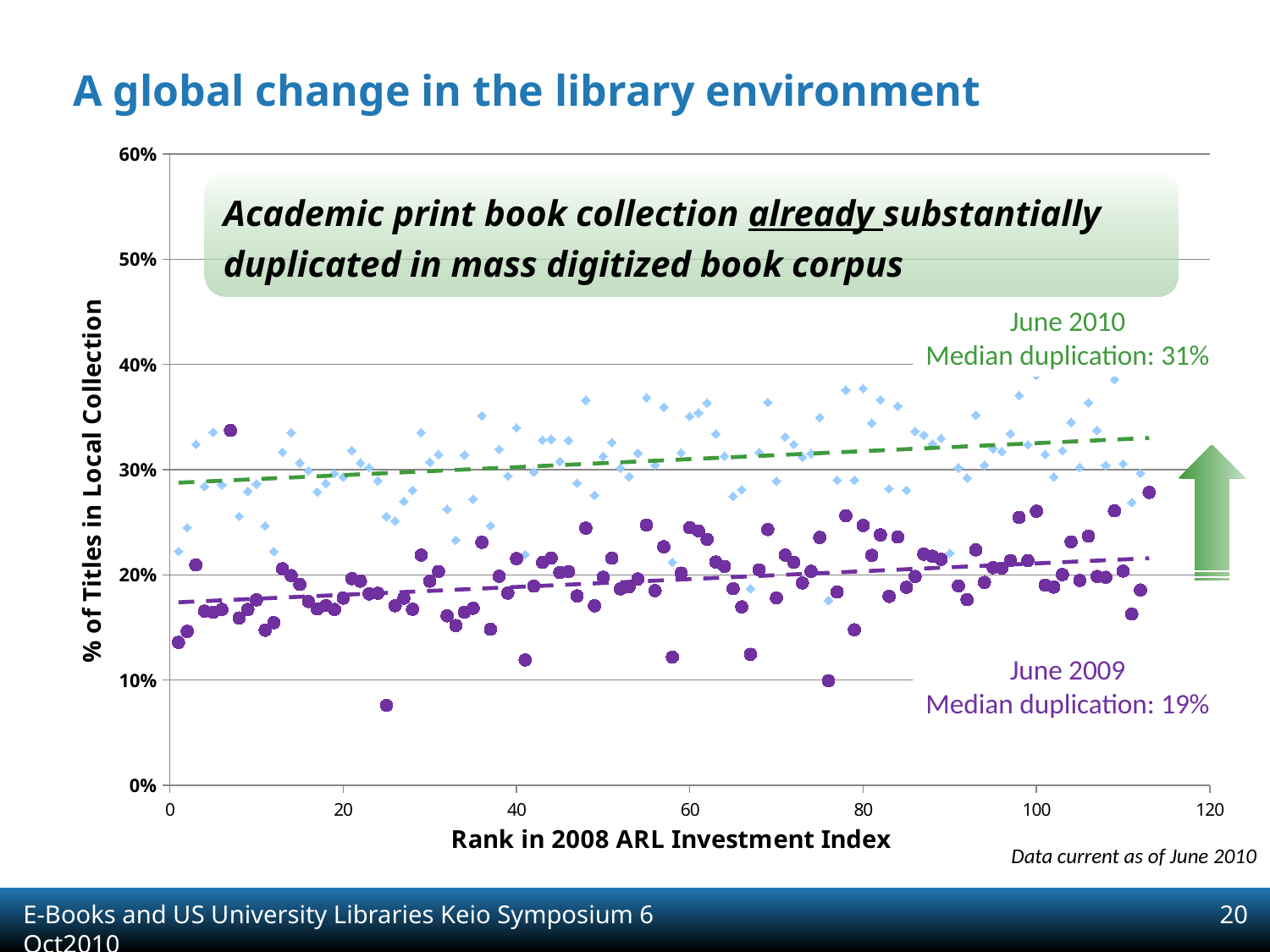
Which has the higher median duplication, June 2009 or June 2010? June 2010 What is the median duplication for June 2009? 19% By how many percentage points does the June 2010 median duplication exceed the June 2009 median duplication? 12 percentage points Is the June 2009 median duplication greater or less than 20%? less Is the June 2010 median duplication greater or less than 30%? greater What is the maximum value shown on the y axis? 60% What is the label of the y axis? % of Titles in Local Collection What kind of chart is shown on the slide? Scatter chart How many data series (time points) are plotted on the chart? 2 What is the label of the x axis? Rank in 2008 ARL Investment Index Do the dashed trend lines rise or fall as the rank in the 2008 ARL Investment Index increases? Rise What is the median duplication for June 2010? 31%